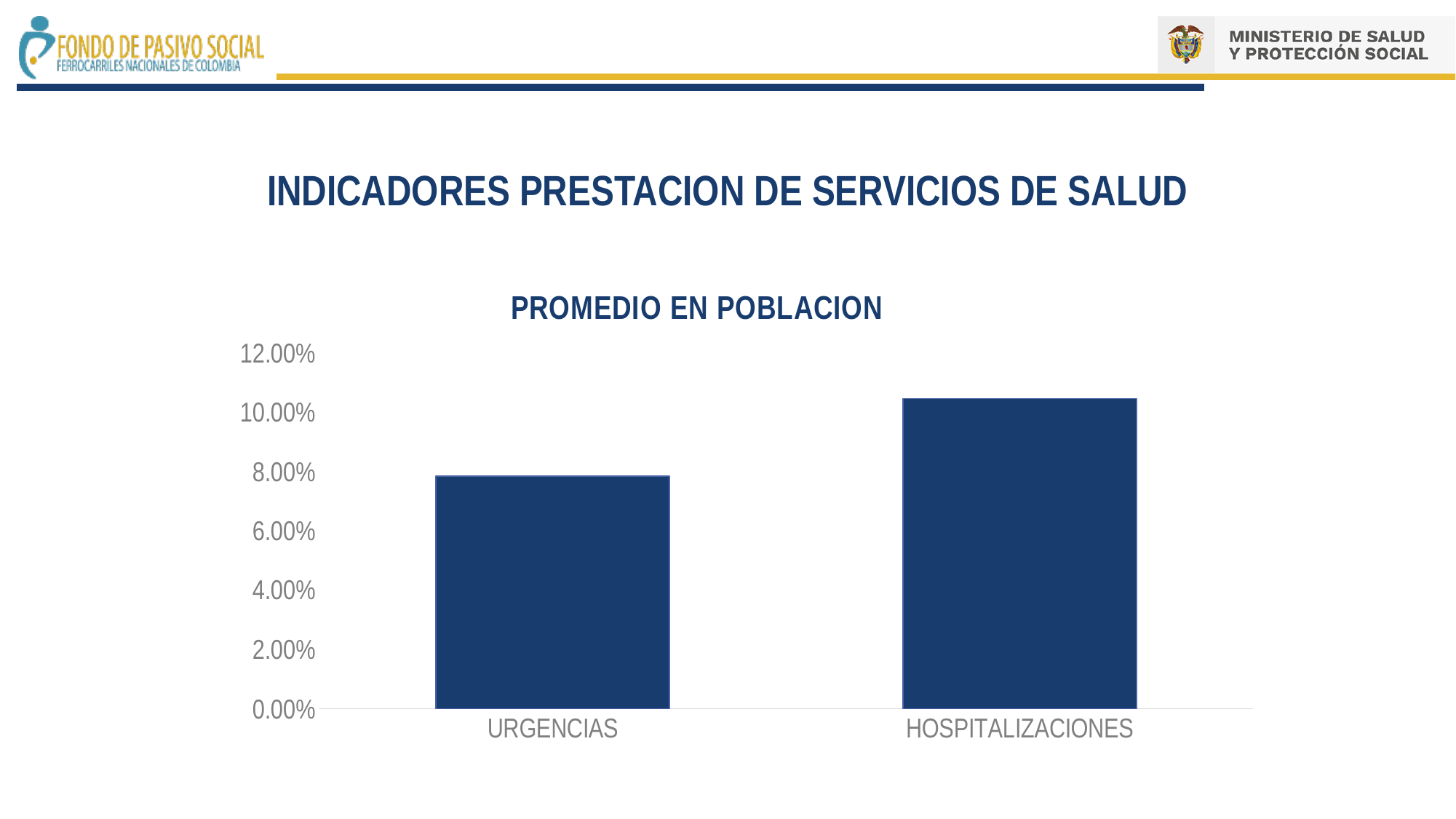
What is the highest value shown on the vertical axis of the chart? 12.00% Do the values rise or fall from URGENCIAS to HOSPITALIZACIONES? rise Is the value for URGENCIAS greater or less than 6.00%? greater Which category has the highest value? HOSPITALIZACIONES How many categories are plotted in the chart? 2 Is the value for HOSPITALIZACIONES greater or less than 12.00%? less Is the value for HOSPITALIZACIONES greater or less than 8.00%? greater Which is larger, the value for URGENCIAS or the value for HOSPITALIZACIONES? HOSPITALIZACIONES What is the title of the chart? PROMEDIO EN POBLACION What kind of chart is shown on the slide? bar chart Which category has the lowest value? URGENCIAS